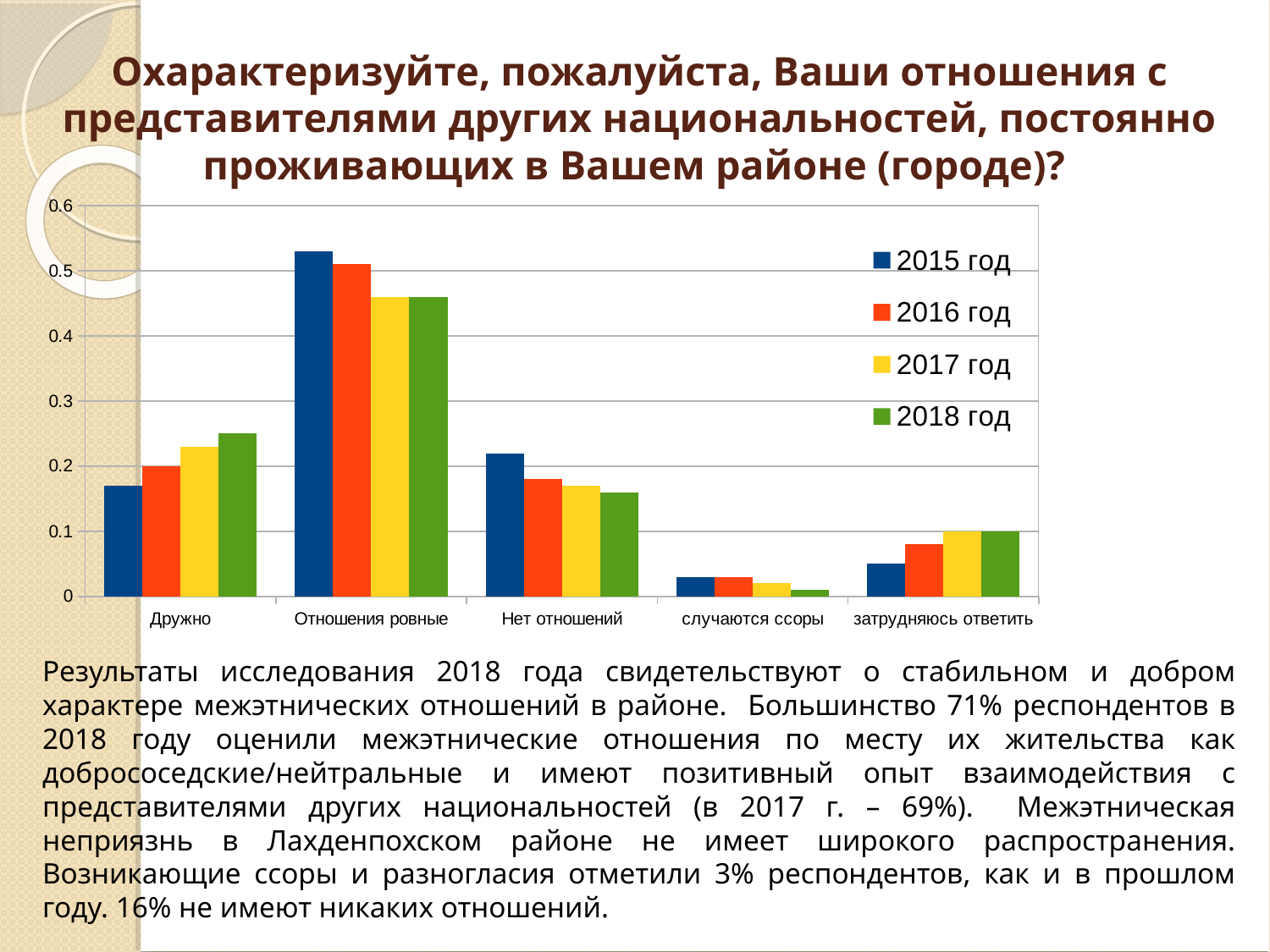
What kind of chart is shown on the slide? bar chart In the category Дружно, which is larger: the value for 2015 год or for 2018 год? 2018 год Is the value for 2015 год in the category Отношения ровные greater or less than 0.5? greater How many series does the legend list? 4 Is the value for 2018 год in the category Дружно greater or less than 0.2? greater Which category has the highest bars? Отношения ровные Which colour represents 2015 год in the legend? blue Do the values for the category Дружно rise or fall from 2015 год to 2018 год? rise In the category Отношения ровные, which is larger: the value for 2015 год or for 2018 год? 2015 год Is the value for 2015 год in the category Нет отношений greater or less than 0.3? less Which category has the lowest bars? случаются ссоры How many categories are shown on the x axis? 5